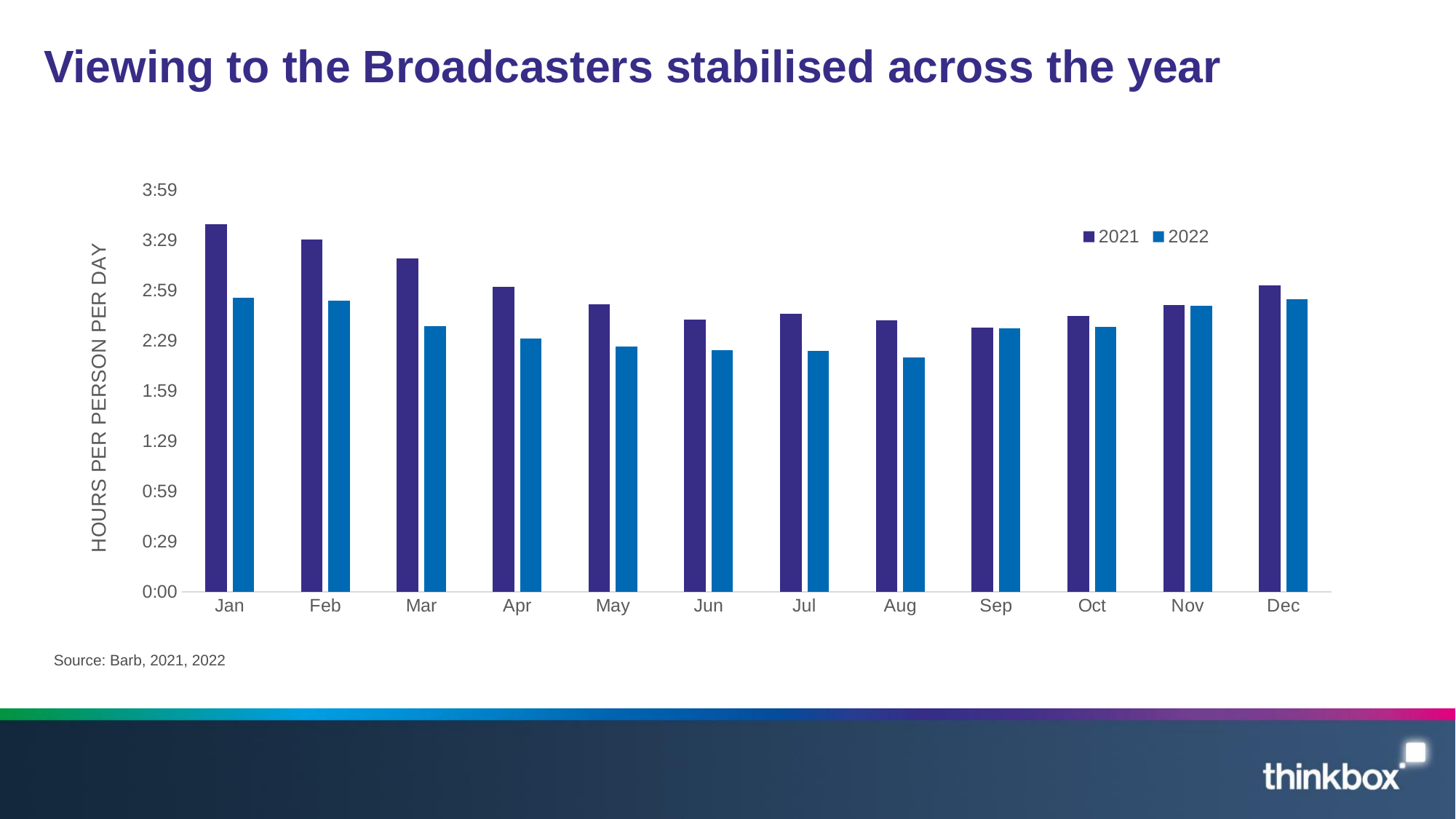
How many months are shown on the x axis? 12 Does the 2021 series rise or fall from Jan to Aug? fall What kind of chart is shown on the slide? bar chart Which month has the highest value for the 2021 series? Jan Is the 2021 value for Jan greater or less than 3:29? greater Is the 2022 value for Nov greater or less than 2:59? less Is the 2021 value for Mar greater or less than 2:59? greater How many series does the legend list? 2 In Jan, which series has the larger value, 2021 or 2022? 2021 In Apr, which series has the larger value, 2021 or 2022? 2021